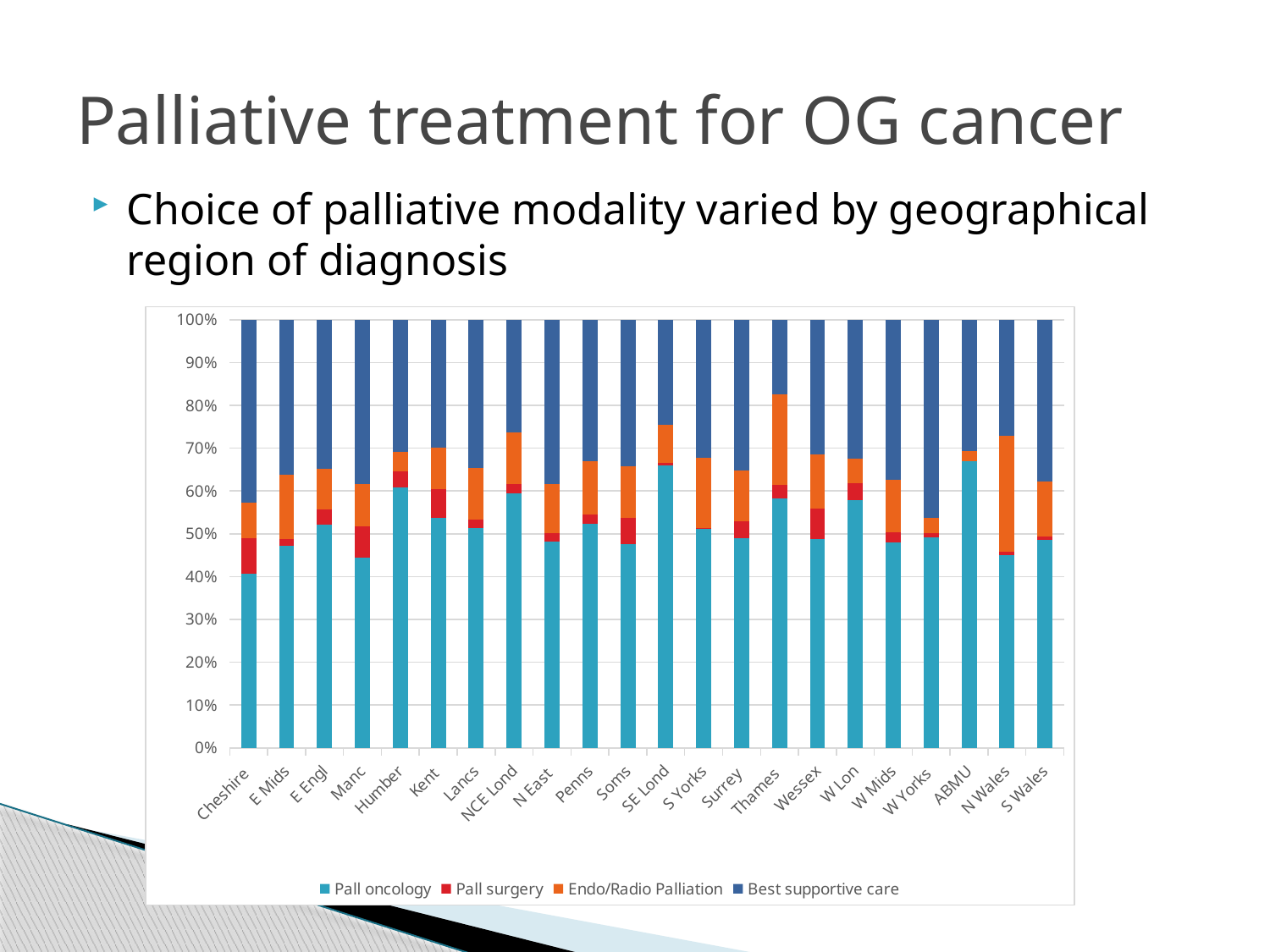
How many regions are shown along the x axis of the chart? 22 What kind of chart is shown on the slide? Stacked bar chart Which series is shown in light blue at the bottom of each bar? Pall oncology Which series is shown in dark blue at the top of each bar? Best supportive care Which region has the larger Pall oncology share, Cheshire or SE Lond? SE Lond Is the Pall oncology value for Cheshire greater or less than 50%? less How many series does the chart legend list? 4 Which region has the larger Pall oncology share, Humber or W Yorks? Humber Is the Pall oncology value for SE Lond greater or less than 60%? greater Is the Pall oncology value for ABMU greater or less than 60%? greater What is the total of each stacked bar in the chart? 100%